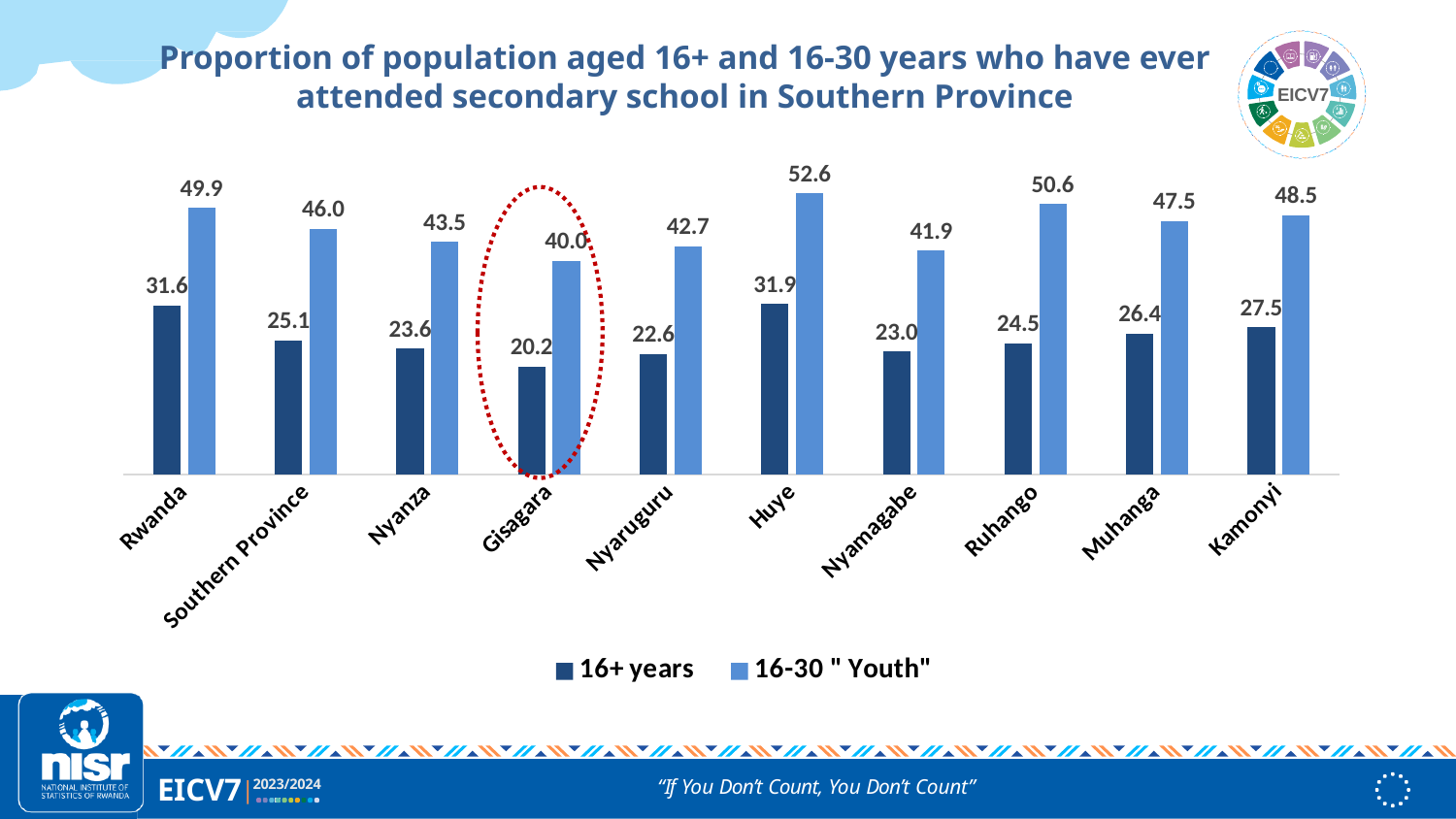
Which category is highlighted with a red dotted circle? Gisagara Which category has the highest value in the 16-30 "Youth" series? Huye Which category has the lowest value in the 16+ years series? Gisagara Which has a larger 16-30 "Youth" value, Ruhango or Muhanga? Ruhango What is the value for the 16+ years series for Rwanda? 31.6 How many series does the legend list? 2 What is the value for the 16+ years series in Gisagara? 20.2 What is the difference between the 16-30 "Youth" value and the 16+ years value in Gisagara? 19.8 What kind of chart is shown on the slide? Bar chart How many categories are shown on the x axis? 10 What is the value for the 16-30 "Youth" series in Huye? 52.6 What is the difference between the 16-30 "Youth" value and the 16+ years value in Huye? 20.7